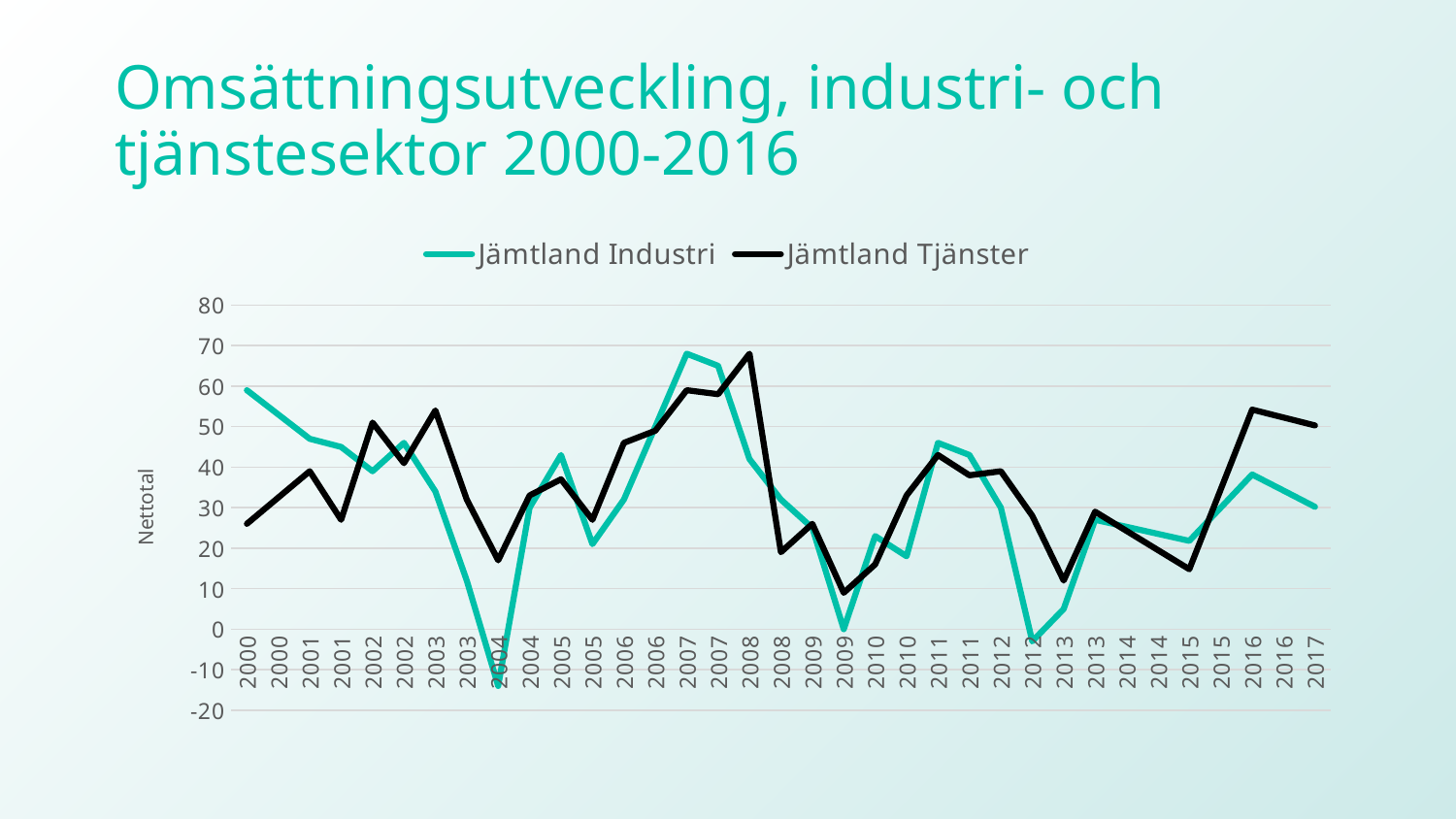
At the first 2000 point, which series has the higher value, Jämtland Industri or Jämtland Tjänster? Jämtland Industri Is the value for Jämtland Tjänster at the first 2008 point greater or less than 60? greater What is the title of the chart on the slide? Omsättningsutveckling, industri- och tjänstesektor 2000-2016 At 2017, which series has the higher value, Jämtland Industri or Jämtland Tjänster? Jämtland Tjänster Is the value for Jämtland Industri at the first 2000 point greater or less than 50? greater Does the Jämtland Industri line rise or fall from the first 2000 point to the first 2004 point? fall Is the value for Jämtland Industri at the first 2004 point greater or less than 0? less How many series does the legend list? 2 What kind of chart is shown on the slide? line chart What is the label on the vertical axis? Nettotal